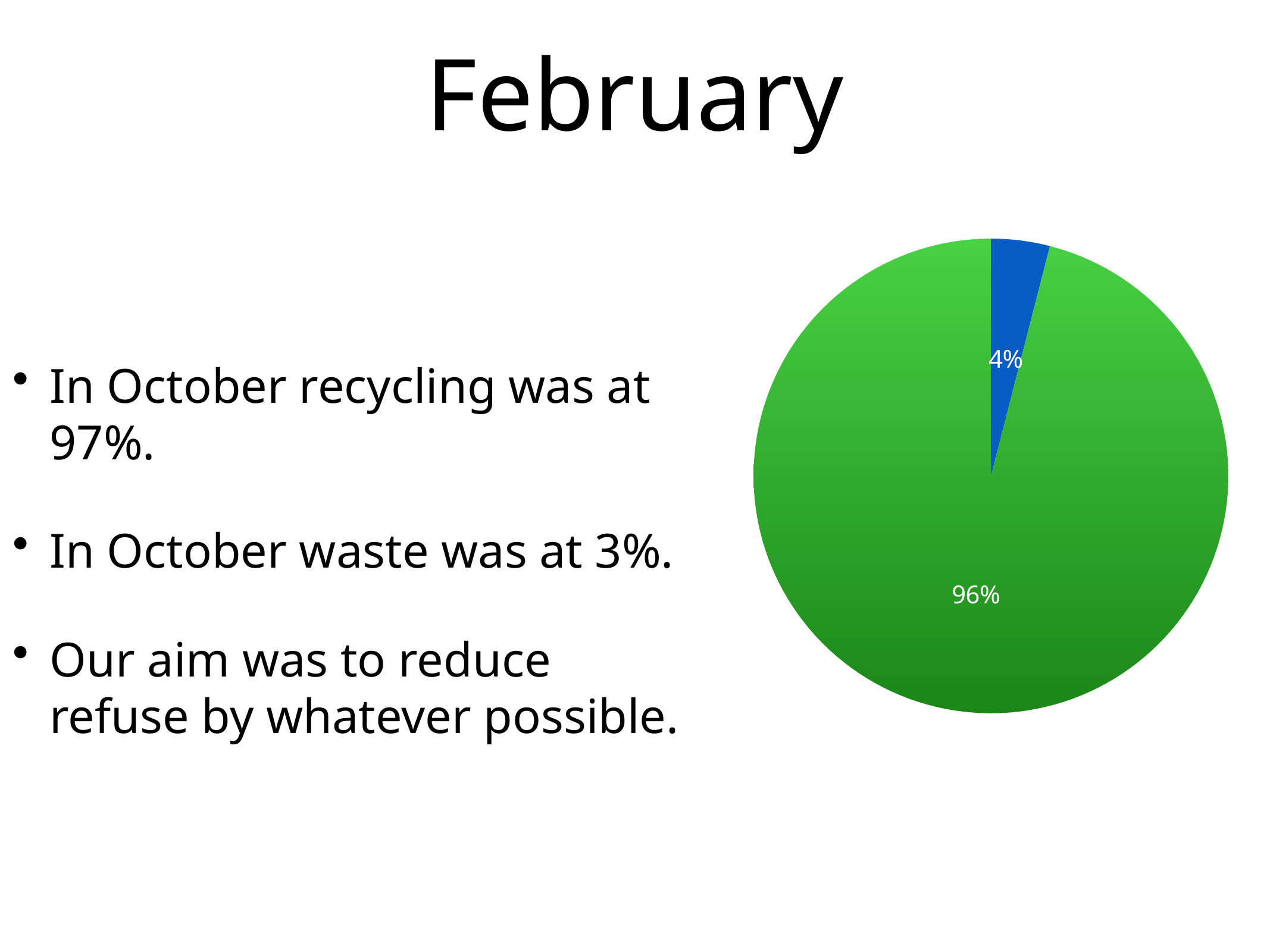
How many slices does the pie chart have? 2 What is the difference in percentage points between the green slice and the blue slice? 92 What kind of chart is shown on the slide? pie chart Which slice of the pie chart is the smallest? the blue slice (4%) Which slice of the pie chart is the largest? the green slice (96%) What is the title of the slide containing the pie chart? February What colour is the largest slice of the pie chart? green What share of the pie does the blue slice represent? 4% What percentage is shown on the green slice of the pie chart? 96% Which is larger, the blue slice or the green slice? the green slice What percentage is shown on the blue slice of the pie chart? 4% What is the total of the two slice percentages shown on the pie chart? 100%